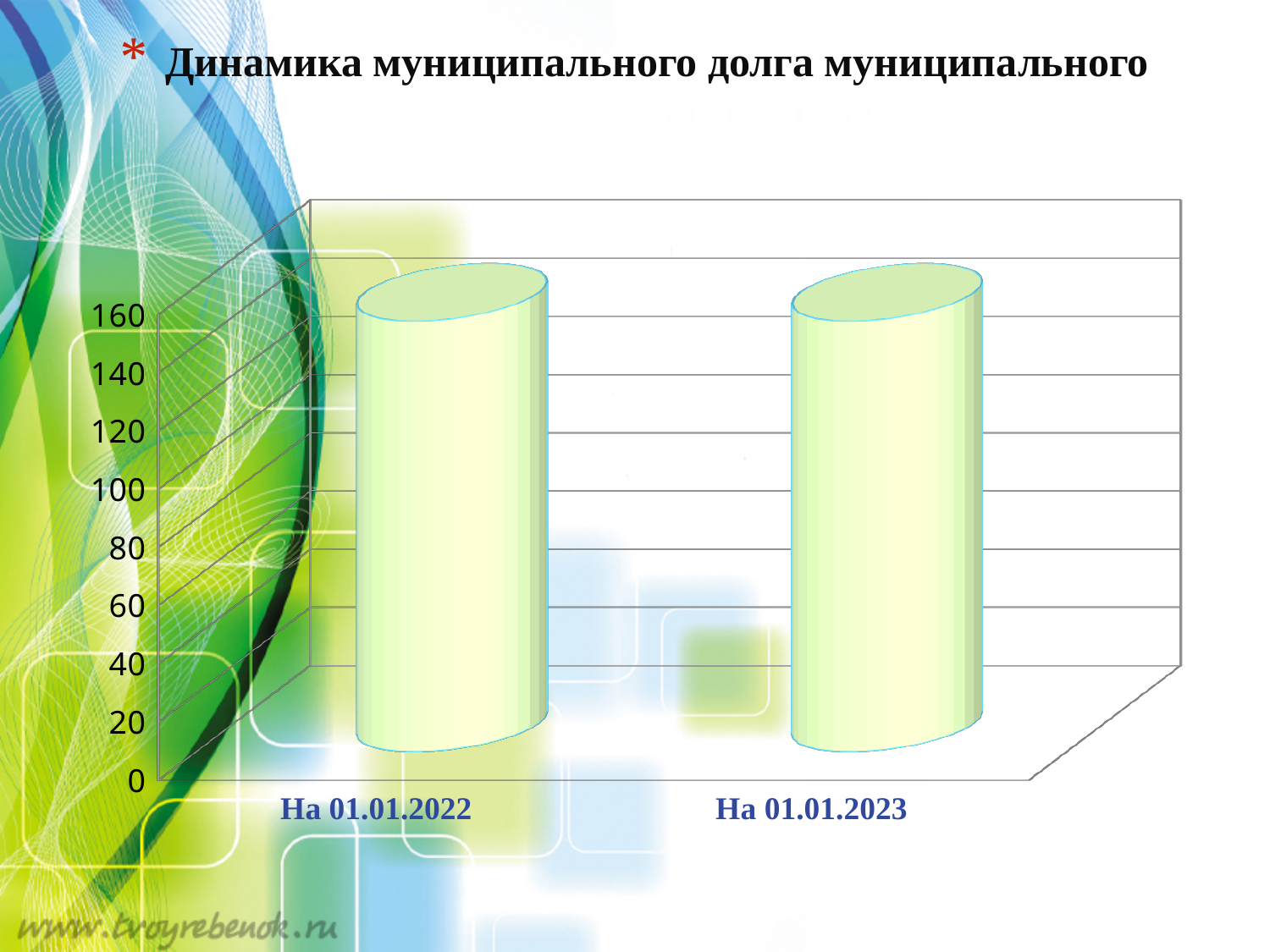
Is the value for На 01.01.2022 greater or less than 120? greater Is the value for На 01.01.2022 greater or less than 100? greater Is the value for На 01.01.2023 greater or less than 60? greater How many categories are plotted on the x axis of the chart? 2 What is the highest value shown on the vertical axis of the chart? 160 What is the label of the first category on the x axis? На 01.01.2022 What kind of chart is shown on the slide? bar chart